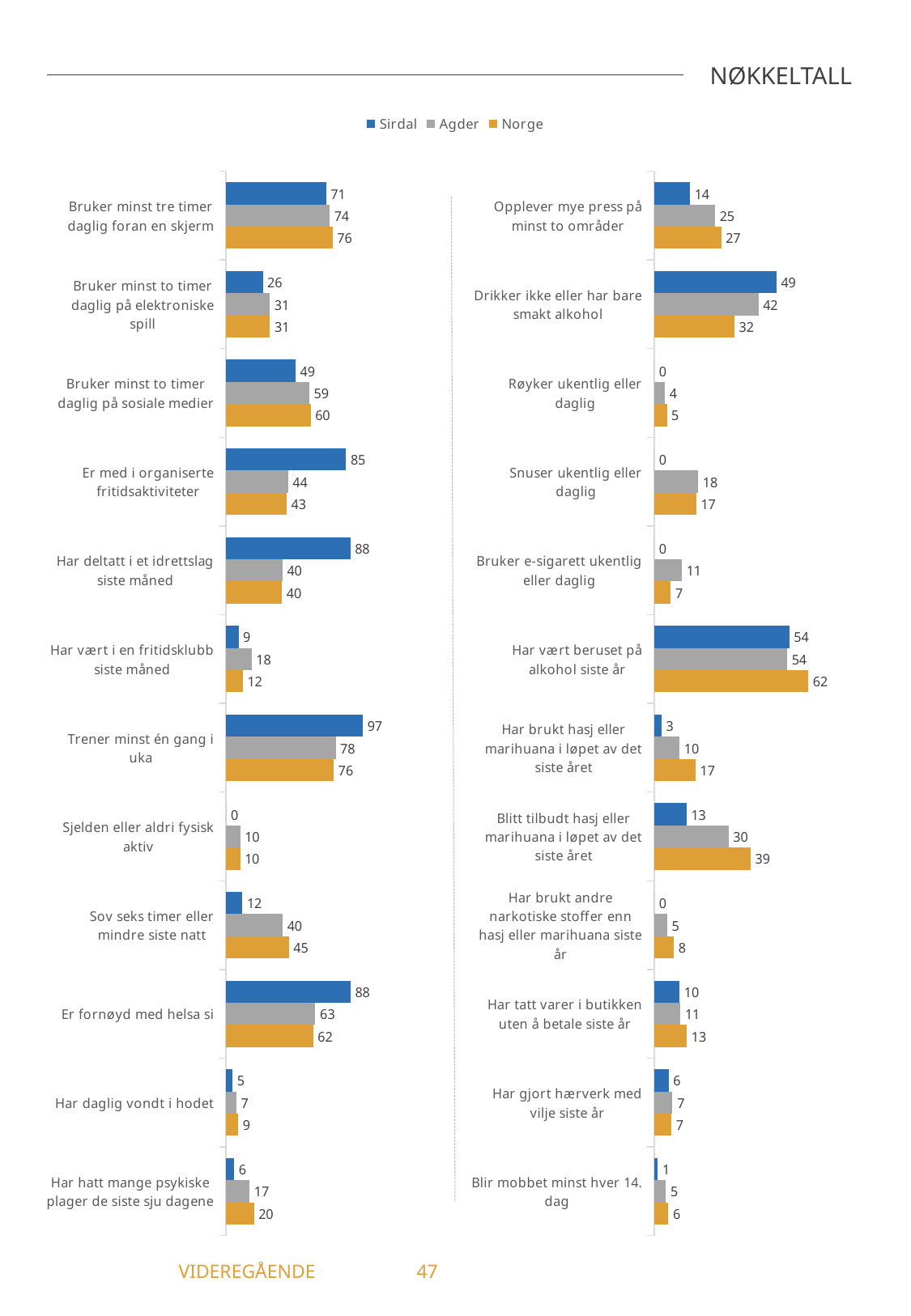
In the right chart, which series has the highest value for 'Drikker ikke eller har bare smakt alkohol'? Sirdal In the right chart, is the value for Agder or Norge larger for 'Opplever mye press på minst to områder'? Norge What kind of chart is used on this slide? Bar chart In the left chart, which series has the lowest value for 'Har vært i en fritidsklubb siste måned'? Sirdal How many categories are shown in the right chart? 12 In the left chart, is the value for Sirdal or Norge larger for 'Er fornøyd med helsa si'? Sirdal In the left chart, what is the value for Sirdal for 'Trener minst én gang i uka'? 97 In the left chart, what is the value for Agder for 'Sov seks timer eller mindre siste natt'? 40 In the right chart, what is the difference between Norge and Sirdal for 'Blitt tilbudt hasj eller marihuana i løpet av det siste året'? 26 How many series does the legend list? 3 In the left chart, what is the difference between Sirdal and Agder for 'Er med i organiserte fritidsaktiviteter'? 41 In the right chart, what is the value for Norge for 'Har vært beruset på alkohol siste år'? 62